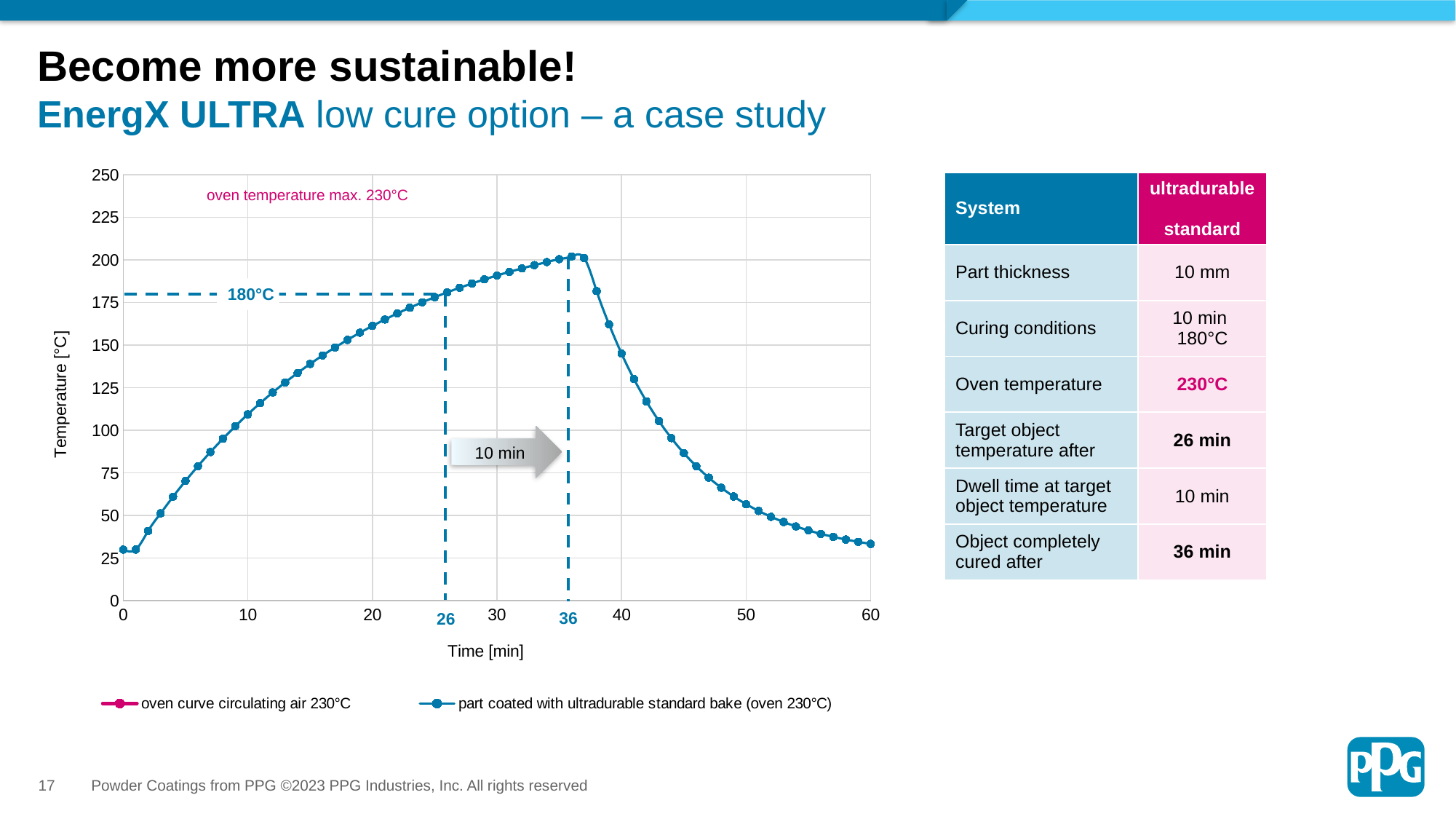
At what time does the part temperature curve reach its peak? 36 min How many series does the chart legend list? 2 Is the part temperature at 10 minutes greater or less than 100°C? greater Is the part temperature at 30 minutes greater or less than 175°C? greater What maximum oven temperature is stated in the annotation at the top of the chart? 230°C Is the part temperature at 45 minutes greater or less than 100°C? less Does the part temperature rise or fall between 40 and 60 minutes? fall Does the part temperature rise or fall between 0 and 26 minutes? rise According to the dashed annotation, what temperature does the coated part reach at 26 minutes? 180°C What kind of chart is shown on the slide? line chart What is the label of the chart's x axis? Time [min]